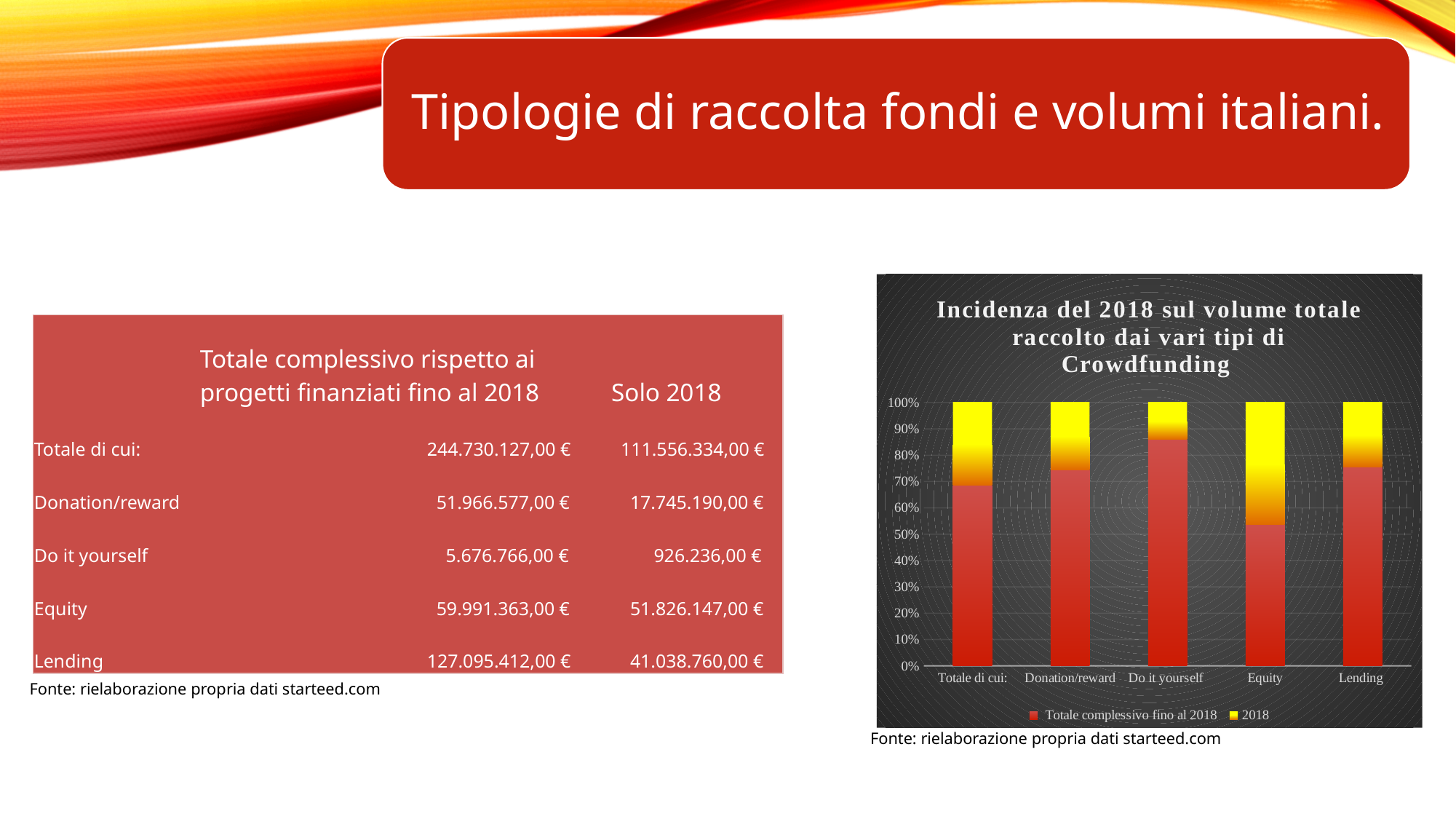
Is the 'Totale complessivo fino al 2018' share for Do it yourself greater or less than 80%? greater How many series does the chart's legend list? 2 What is the title of the chart? Incidenza del 2018 sul volume totale raccolto dai vari tipi di Crowdfunding Which is larger: the 'Totale complessivo fino al 2018' share for Do it yourself or for Equity? Do it yourself Which category has the smallest share for the '2018' series? Do it yourself Is the 'Totale complessivo fino al 2018' share for Equity greater or less than 60%? less Which category has the largest share for 'Totale complessivo fino al 2018'? Do it yourself What does each stacked bar in the chart total? 100% What kind of chart is shown on the slide? Stacked bar chart Which two series are listed in the chart's legend? Totale complessivo fino al 2018 and 2018 Which category has the largest share for the '2018' series? Equity How many categories are shown on the x axis of the chart? 5